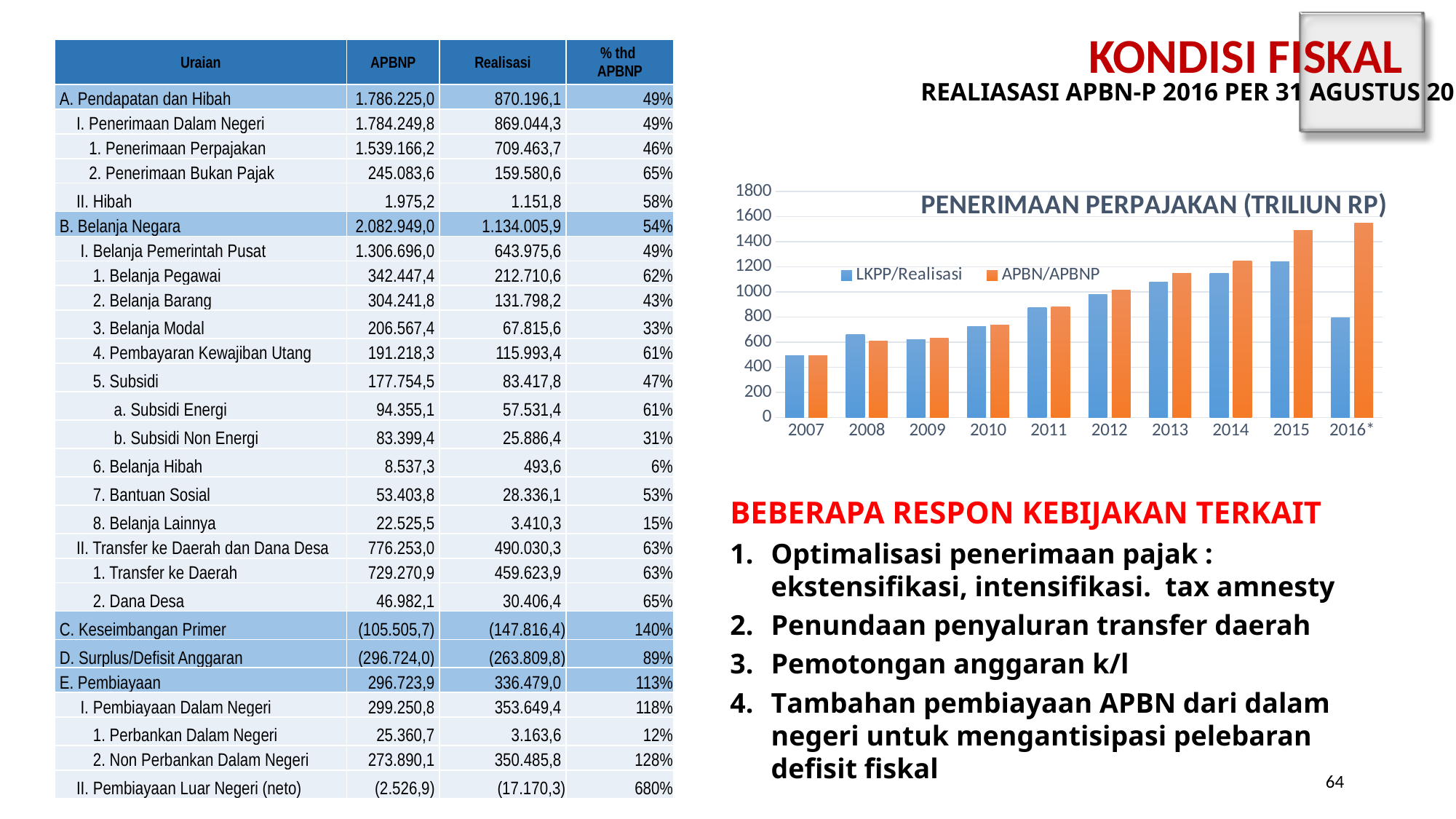
How many years are shown on the x axis of the chart? 10 How many series does the chart's legend list? 2 What kind of chart is shown on the slide? bar chart What is the title of the chart on the slide? PENERIMAAN PERPAJAKAN (TRILIUN RP) Which year has the highest APBN/APBNP bar in the chart? 2016* Do the APBN/APBNP values generally rise or fall from 2007 to 2016*? rise Which is larger in the chart: the LKPP/Realisasi value for 2015 or for 2016*? 2015 Is the APBN/APBNP value for 2016* greater or less than 1400? greater Is the APBN/APBNP value for 2013 greater or less than 1000? greater Which year has the lowest LKPP/Realisasi bar in the chart? 2007 Which colour represents the APBN/APBNP series in the chart? orange Is the LKPP/Realisasi value for 2007 greater or less than 600? less